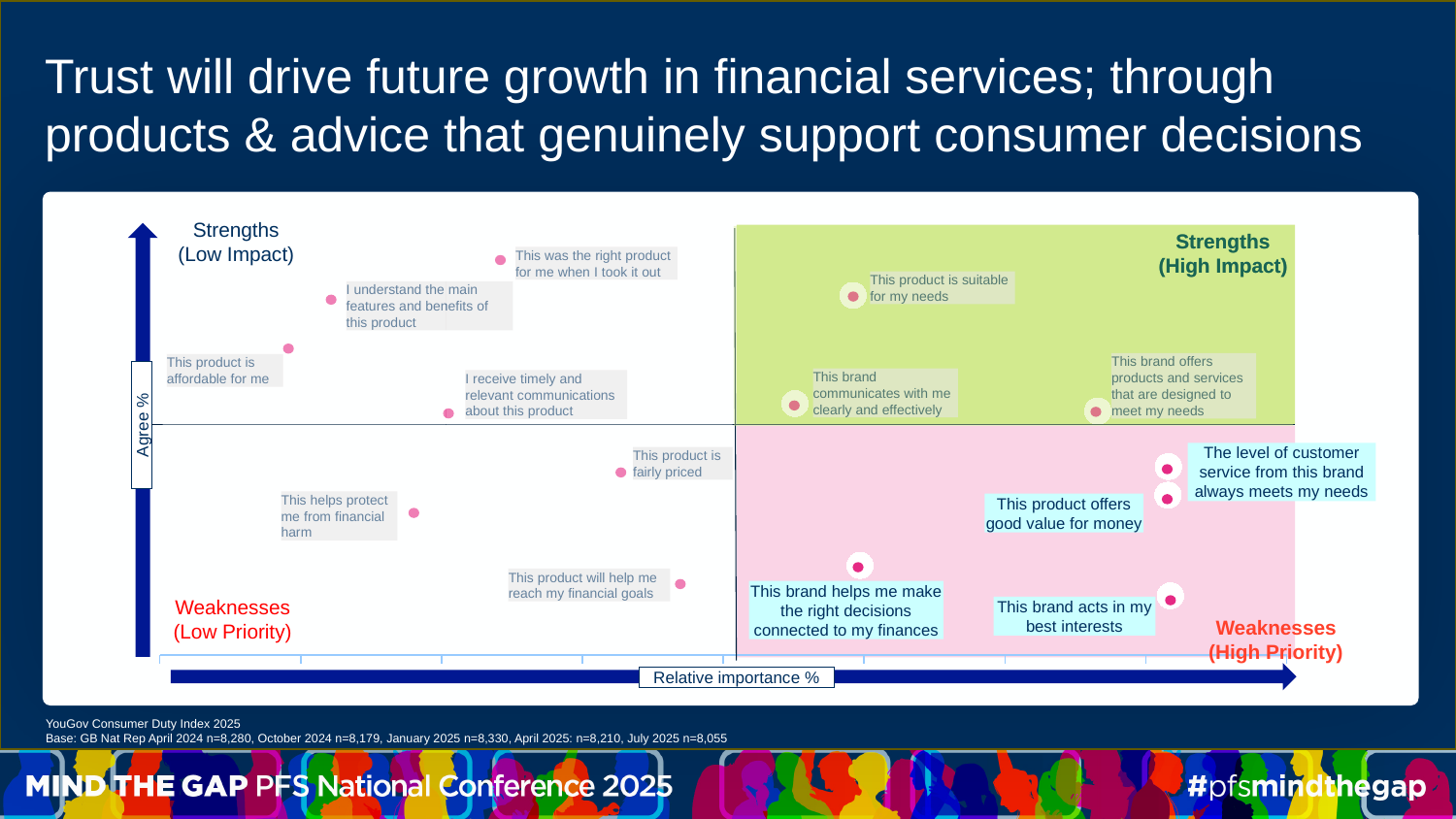
How many points fall in the Weaknesses (High Priority) quadrant? 4 Which quadrant contains the point 'This brand acts in my best interests'? Weaknesses (High Priority) Which quadrant contains the point 'This product is suitable for my needs'? Strengths (High Impact) What is the label of the horizontal axis? Relative importance % Which statement has the lowest relative importance (is furthest left) on the chart? This product is affordable for me Which has a higher Agree %: 'This product is affordable for me' or 'This helps protect me from financial harm'? This product is affordable for me Which statement has the highest Agree % on the chart? This was the right product for me when I took it out How many points fall in the Strengths (High Impact) quadrant? 3 How many data points are plotted on the chart? 14 What kind of chart is shown on the slide? Scatter plot Which quadrant contains the point 'This helps protect me from financial harm'? Weaknesses (Low Priority) What is the label of the vertical axis? Agree %